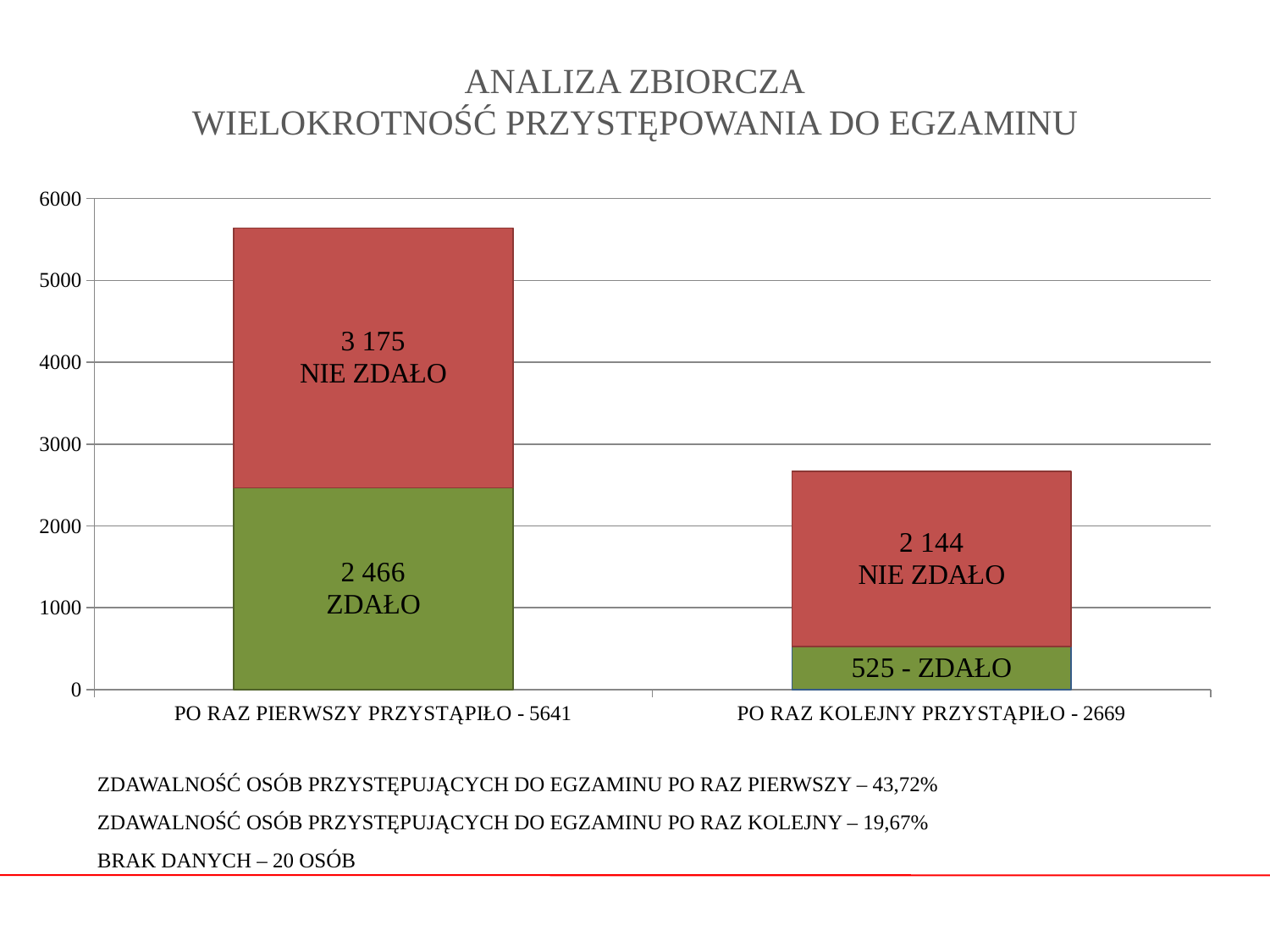
How many categories are shown on the x axis? 2 Which is larger: the number who passed among first-time takers (2 466) or the number who did not pass among repeat takers (2 144)? 2 466 (ZDAŁO, PO RAZ PIERWSZY) What is the total of the stacked bar for PO RAZ PIERWSZY PRZYSTĄPIŁO? 5641 How many people passed (ZDAŁO) among those taking the exam again (PO RAZ KOLEJNY PRZYSTĄPIŁO)? 525 How many people did not pass (NIE ZDAŁO) among those taking the exam for the first time (PO RAZ PIERWSZY PRZYSTĄPIŁO)? 3 175 What kind of chart is shown on the slide? stacked bar chart How many people did not pass (NIE ZDAŁO) among those taking the exam again (PO RAZ KOLEJNY PRZYSTĄPIŁO)? 2 144 What is the total of the stacked bar for PO RAZ KOLEJNY PRZYSTĄPIŁO? 2669 Which category has the higher total bar? PO RAZ PIERWSZY PRZYSTĄPIŁO What is the difference between the number who did not pass and the number who passed among first-time takers (PO RAZ PIERWSZY PRZYSTĄPIŁO)? 709 How many people passed (ZDAŁO) among those taking the exam for the first time (PO RAZ PIERWSZY PRZYSTĄPIŁO)? 2 466 Is the total bar for PO RAZ KOLEJNY PRZYSTĄPIŁO greater or less than 3000? less